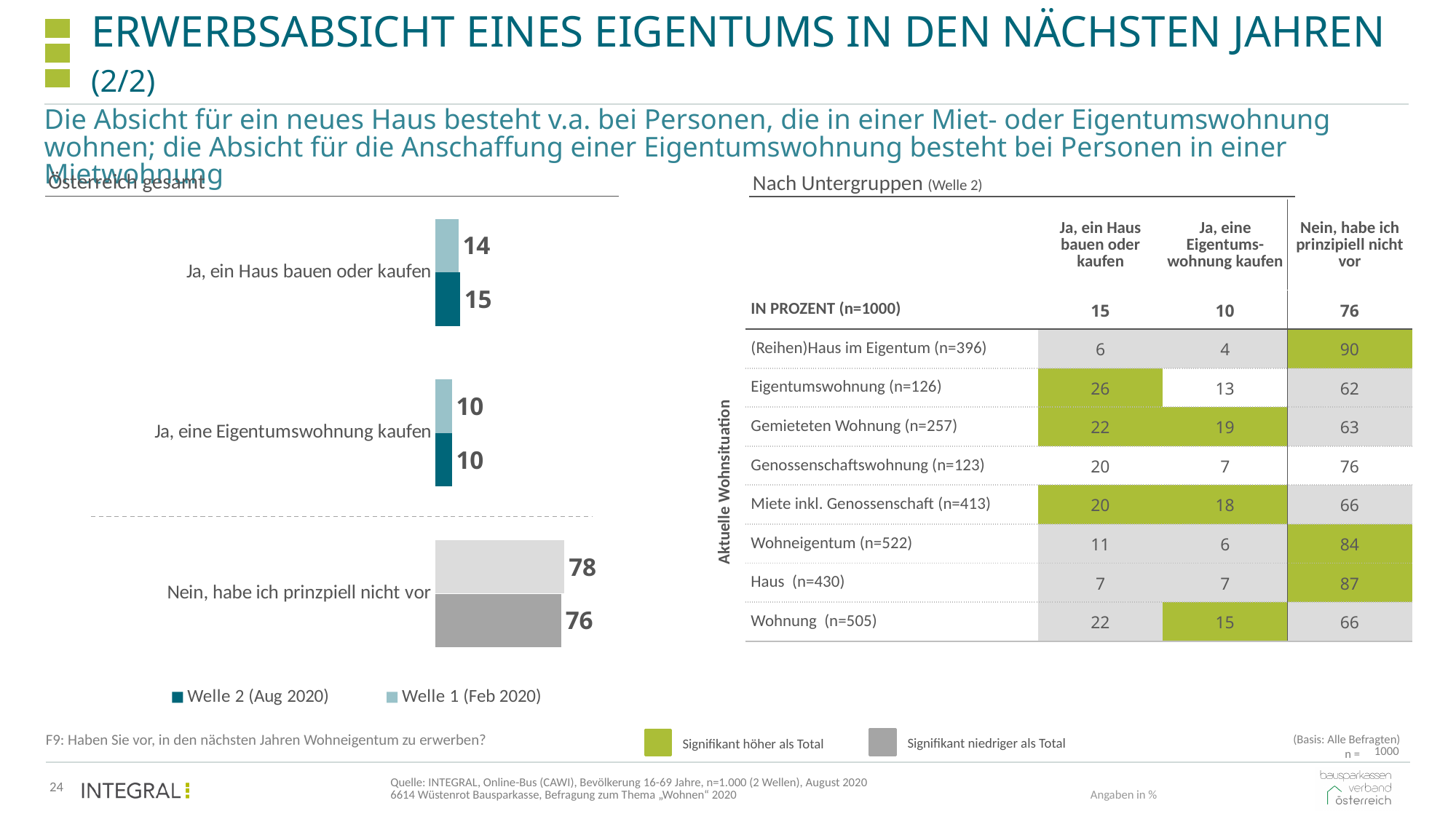
In the "Österreich gesamt" chart, what is the Welle 1 (Feb 2020) value for "Nein, habe ich prinzpiell nicht vor"? 78 In the "Österreich gesamt" chart, what is the difference between the Welle 1 and Welle 2 values for "Nein, habe ich prinzpiell nicht vor"? 2 In the "Österreich gesamt" chart, which is larger for "Ja, ein Haus bauen oder kaufen": the Welle 1 (Feb 2020) value or the Welle 2 (Aug 2020) value? Welle 2 (Aug 2020) What type of chart is the "Österreich gesamt" chart? Bar chart In the "Österreich gesamt" chart, which category has the highest Welle 2 (Aug 2020) value? Nein, habe ich prinzpiell nicht vor In the "Österreich gesamt" chart, what is the Welle 2 (Aug 2020) value for "Ja, ein Haus bauen oder kaufen"? 15 In the "Österreich gesamt" chart, which category has the lowest Welle 1 (Feb 2020) value? Ja, eine Eigentumswohnung kaufen How many categories does the "Österreich gesamt" bar chart show? 3 How many series does the legend of the "Österreich gesamt" chart list? 2 In the "Österreich gesamt" chart, what is the Welle 2 (Aug 2020) value for "Nein, habe ich prinzpiell nicht vor"? 76 In the "Österreich gesamt" chart, what is the Welle 1 (Feb 2020) value for "Ja, ein Haus bauen oder kaufen"? 14 In the "Österreich gesamt" chart, what is the Welle 2 (Aug 2020) value for "Ja, eine Eigentumswohnung kaufen"? 10